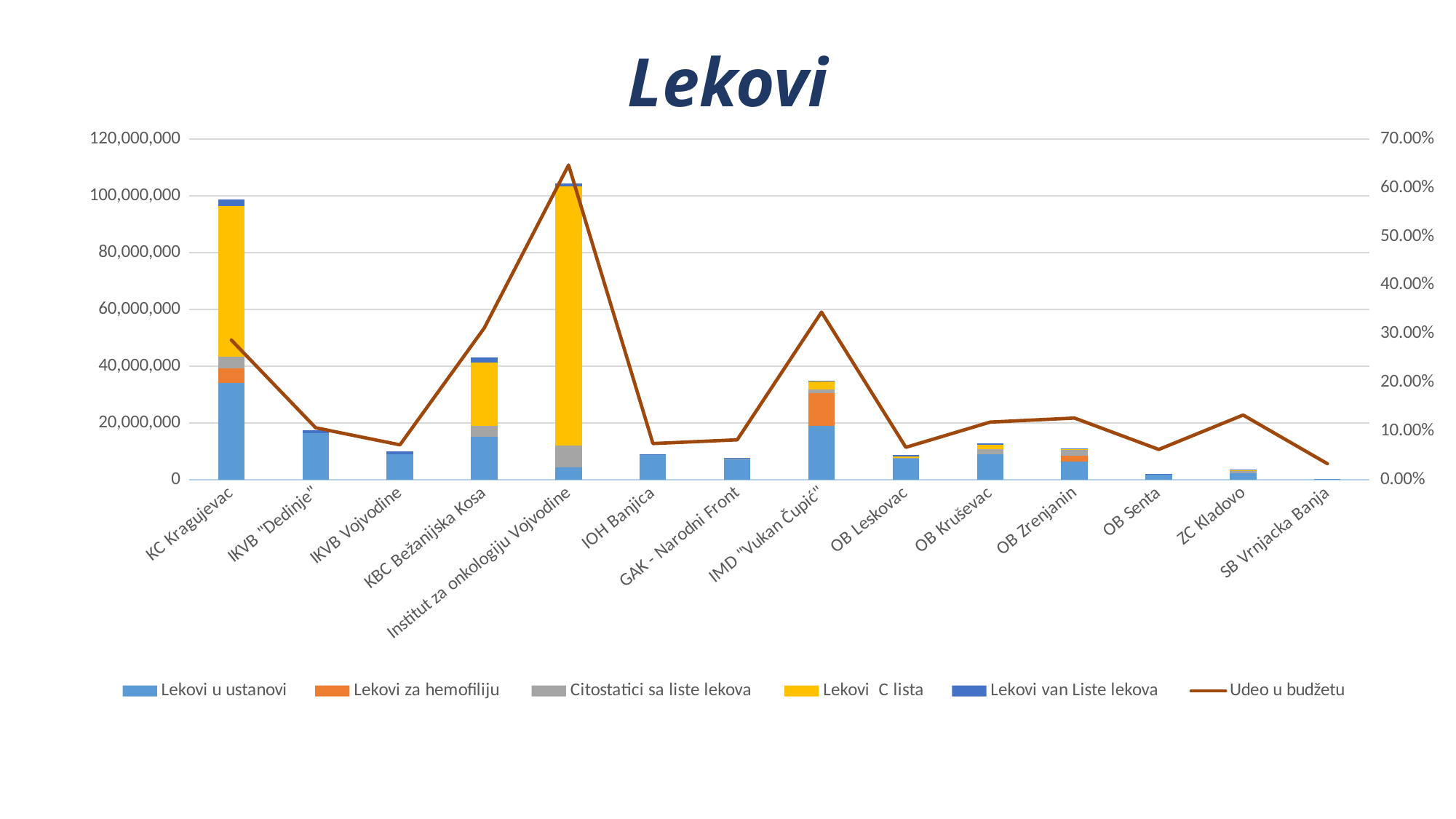
What kind of chart is shown on the slide? A stacked bar chart combined with a line chart Which series is shown in yellow in the legend? Lekovi C lista What is the title of the chart? Lekovi Which institution has the smallest stacked bar? SB Vrnjacka Banja How many series does the legend list? 7 Is the total bar value for IKVB "Dedinje" greater or less than 20,000,000? less Is the Udeo u budžetu value for Institut za onkologiju Vojvodine greater or less than 60.00%? greater How many institutions (categories) are shown on the x axis? 14 Which has the larger total bar, OB Kruševac or OB Senta? OB Kruševac Which institution has the tallest stacked bar? Institut za onkologiju Vojvodine Is the total bar value for KC Kragujevac greater or less than 80,000,000? greater Which institution has the highest value on the Udeo u budžetu line? Institut za onkologiju Vojvodine